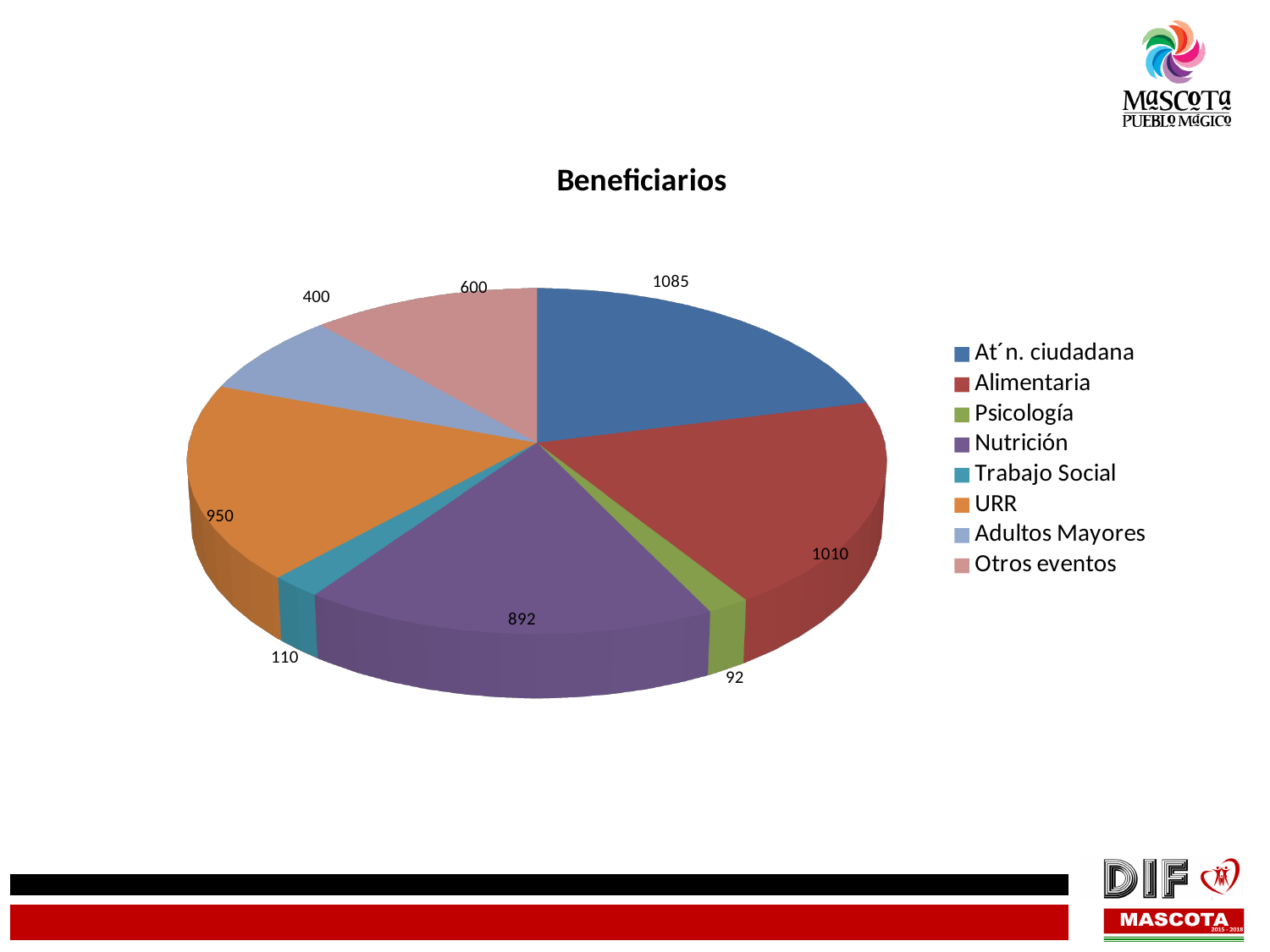
What is the value for Nutrición? 892 What is the total of all the values in the pie chart? 5139 What is the difference between the values for URR and Otros eventos? 350 What is the value for At´n. ciudadana? 1085 What colour is the slice for Trabajo Social? Teal Which category has the smallest value? Psicología What is the value for Adultos Mayores? 400 What type of chart is shown on the slide? Pie chart What is the title of the chart? Beneficiarios Which category has the largest value? At´n. ciudadana Which is larger, the value for Alimentaria or the value for URR? Alimentaria How many categories does the legend list? 8